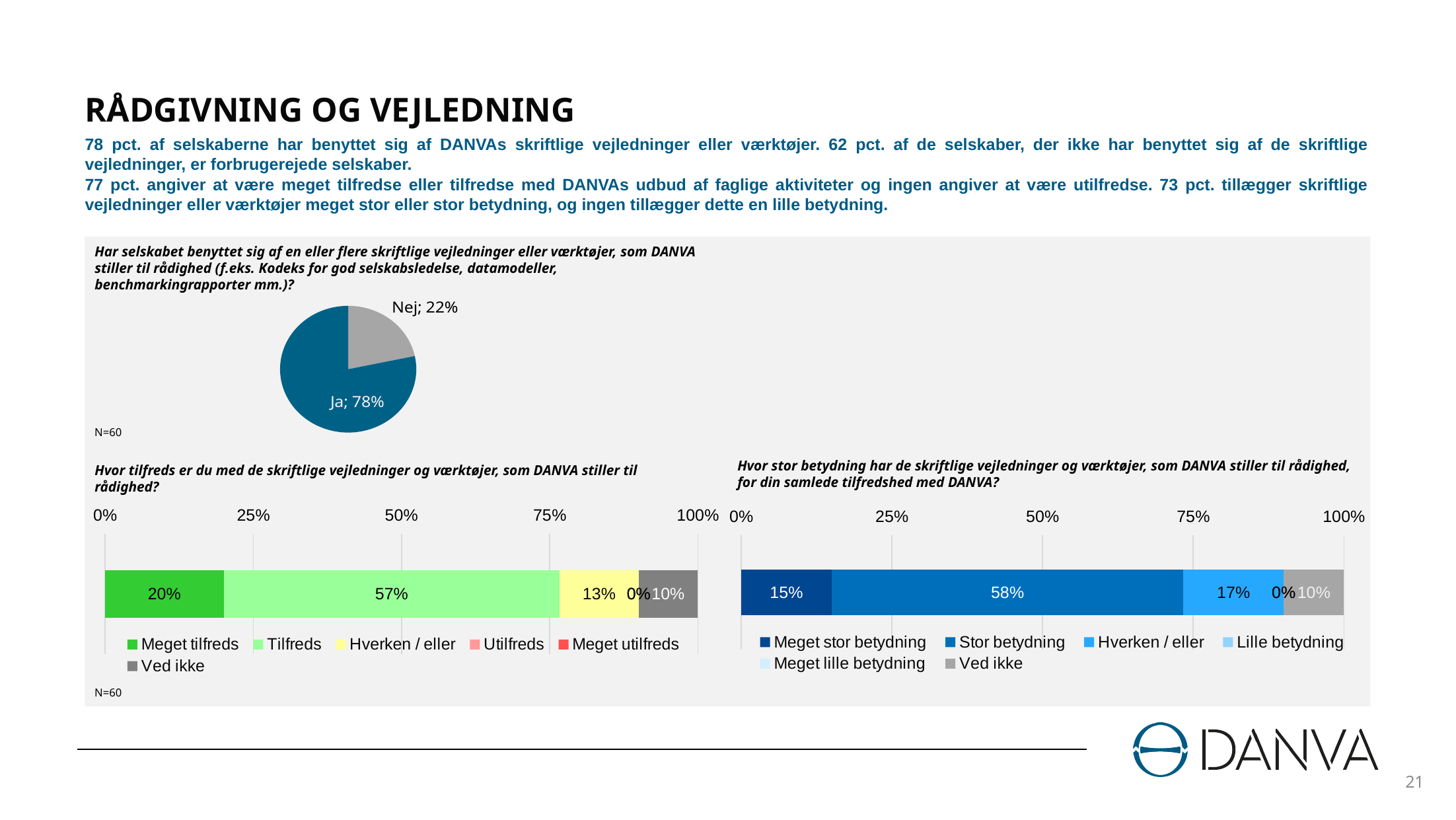
In the bottom-left chart about satisfaction with DANVA's written guidelines and tools, what is the difference between "Tilfreds" and "Meget tilfreds"? 37 percentage points In the bottom-right chart about the importance of DANVA's written guidelines and tools, what is the value for "Stor betydning"? 58% In the pie chart about whether the company has used DANVA's written guidelines or tools, what share answered "Nej"? 22% In the bottom-left chart about satisfaction with DANVA's written guidelines and tools, what is the value for "Meget tilfreds"? 20% In the pie chart about use of DANVA's written guidelines, which answer has the larger slice, "Ja" or "Nej"? Ja In the bottom-right chart about the importance of DANVA's written guidelines and tools, which series has the largest segment? Stor betydning In the bottom-left chart about satisfaction with DANVA's written guidelines and tools, what is the value for "Hverken / eller"? 13% In the bottom-left chart about satisfaction with DANVA's written guidelines and tools, how many series does the legend list? 6 What kind of chart is used for the question about whether the company has used DANVA's written guidelines or tools? Pie chart In the bottom-right chart about the importance of DANVA's written guidelines and tools, which is larger, "Meget stor betydning" or "Hverken / eller"? Hverken / eller In the pie chart about whether the company has used DANVA's written guidelines or tools, what share answered "Ja"? 78% In the bottom-left chart about satisfaction with DANVA's written guidelines and tools, what is the value for "Tilfreds"? 57%